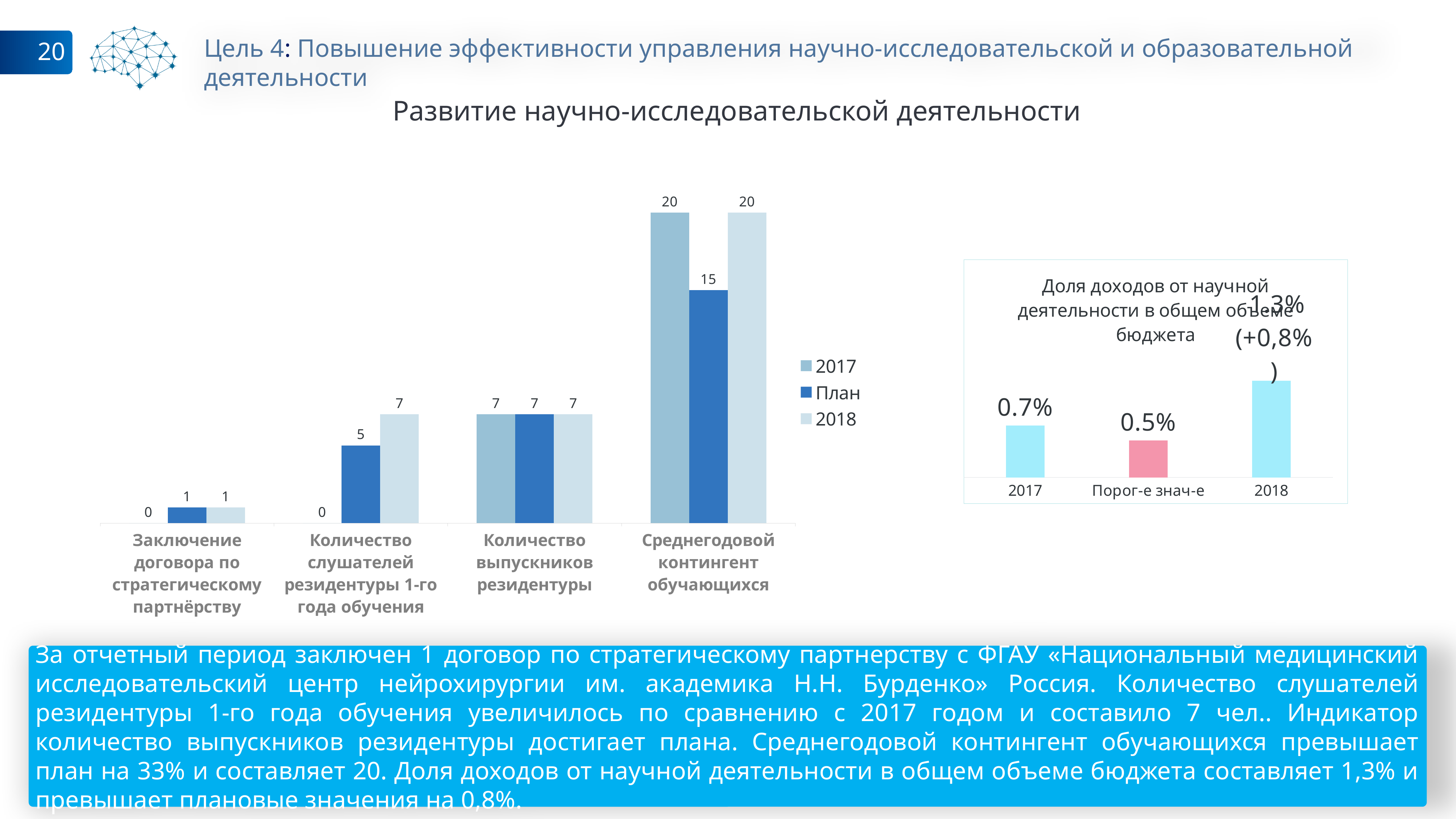
In the left bar chart, what is the 2017 value for Заключение договора по стратегическому партнёрству? 0 In the chart 'Доля доходов от научной деятельности в общем объеме бюджета', what is the value for 2018? 1,3% In the left bar chart, what is the План value for Среднегодовой контингент обучающихся? 15 In the left bar chart, what is the 2018 value for Количество слушателей резидентуры 1-го года обучения? 7 What kind of chart is the chart titled 'Доля доходов от научной деятельности в общем объеме бюджета'? bar chart In the left bar chart, what is the difference between the 2018 value and the План value for Среднегодовой контингент обучающихся? 5 In the chart 'Доля доходов от научной деятельности в общем объеме бюджета', which category has the lowest value? Порог-е знач-е In the left bar chart, how many categories are shown on the x axis? 4 In the left bar chart, which is larger for Количество слушателей резидентуры 1-го года обучения: the План value or the 2018 value? 2018 In the chart 'Доля доходов от научной деятельности в общем объеме бюджета', what is the value for Порог-е знач-е? 0.5% In the left bar chart, how many series does the legend list? 3 In the left bar chart, which category has the highest 2018 value? Среднегодовой контингент обучающихся